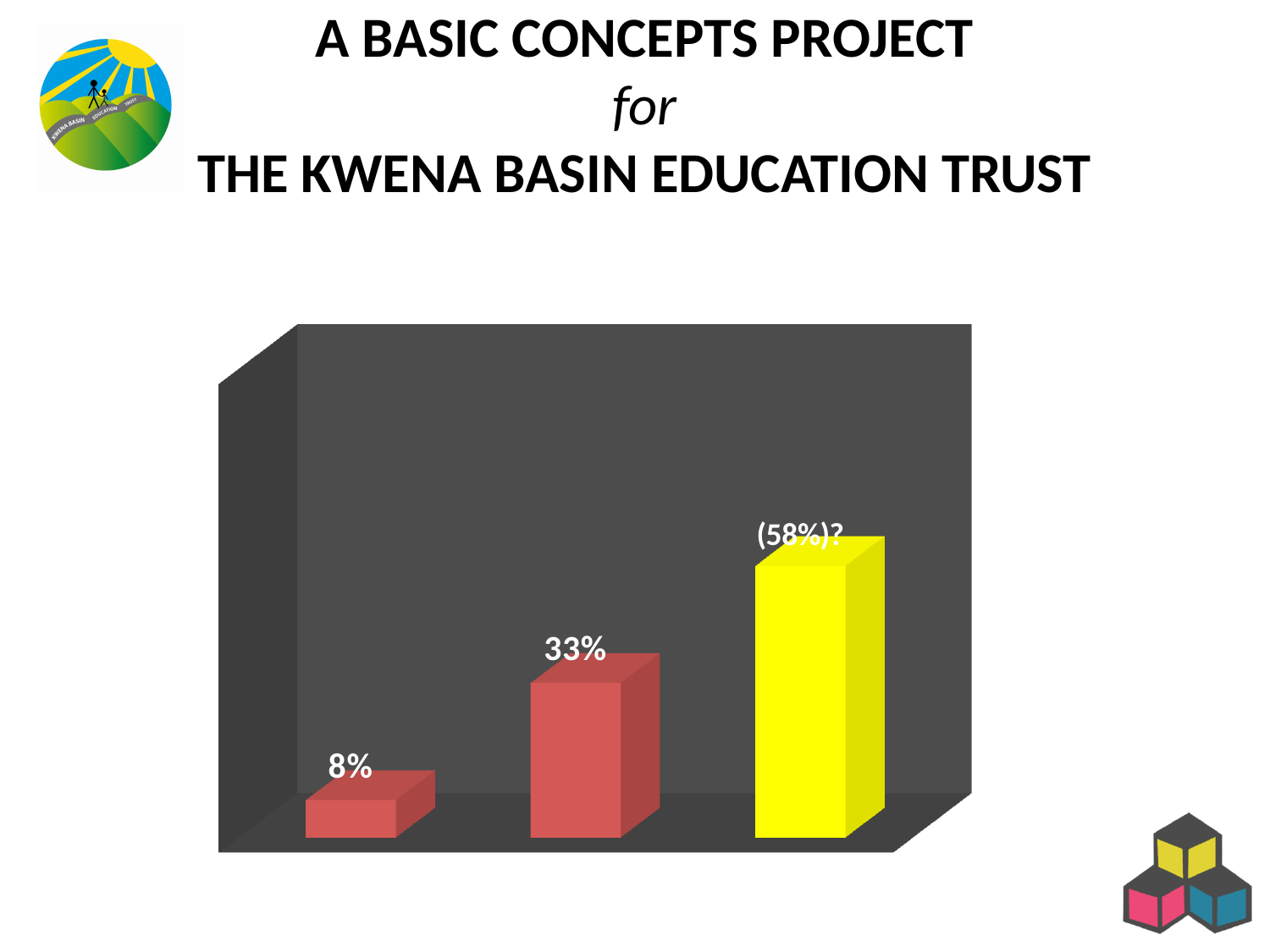
What value is printed on the leftmost bar of the chart? 8% How many bars are plotted in the chart? 3 Which bar is the shortest in the chart: the left, middle or right one? left Which bar is the tallest in the chart: the left, middle or right one? right What colour is the tallest bar in the chart? yellow Do the bar values rise or fall from left to right across the chart? rise What kind of chart is shown on the slide? bar chart Which is larger, the value of the middle bar or the value of the left bar? the middle bar What label is printed above the rightmost (yellow) bar of the chart? (58%)? What colour are the two shorter bars in the chart? red What is the difference between the middle bar's value (33%) and the left bar's value (8%)? 25 percentage points What value is printed on the middle bar of the chart? 33%